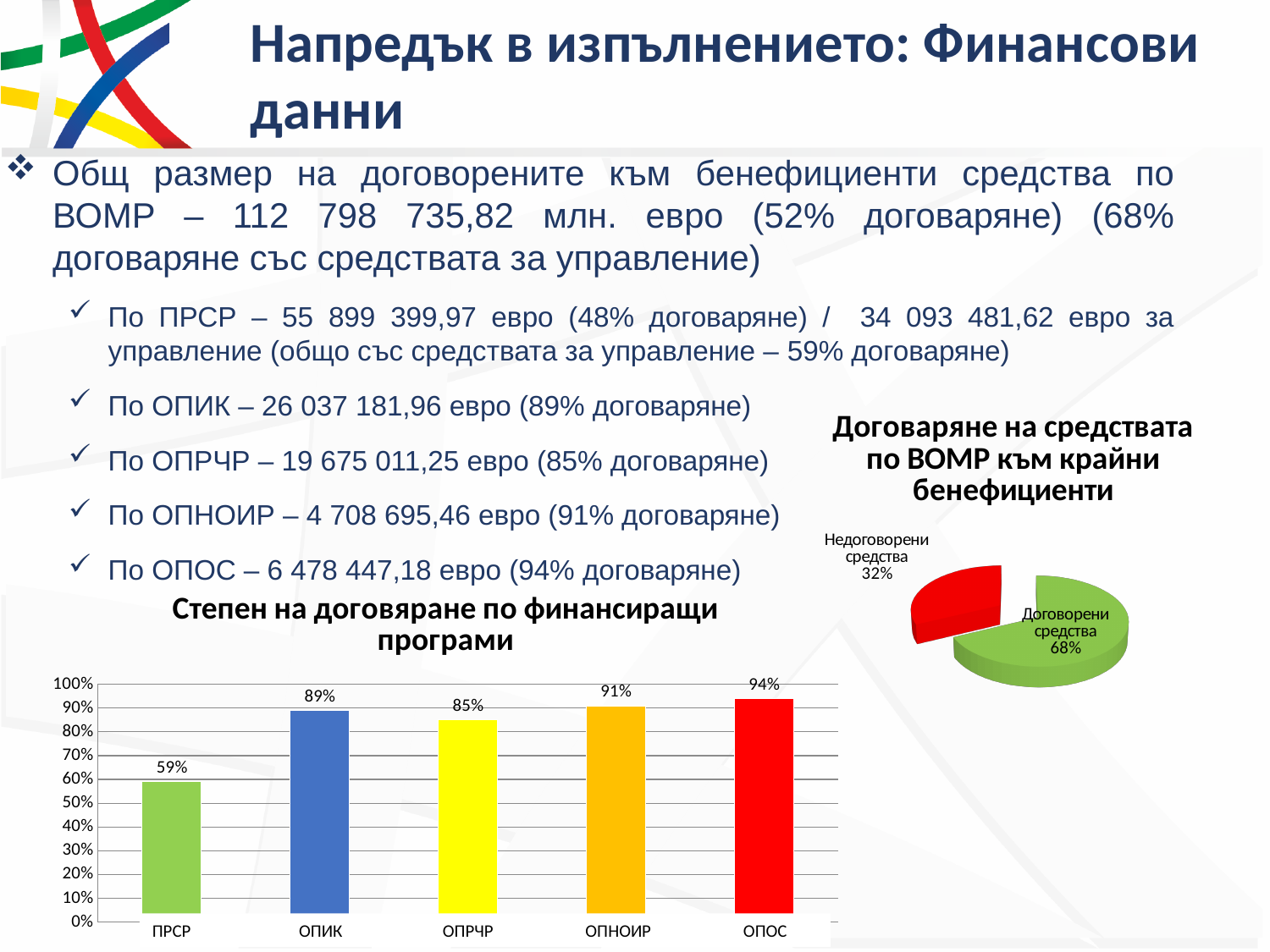
What kind of chart is 'Степен на договяране по финансиращи програми'? Bar chart In the pie chart 'Договаряне на средствата по ВОМР към крайни бенефициенти', how many slices are there? 2 In the bar chart 'Степен на договяране по финансиращи програми', which program has the lowest value? ПРСР In the bar chart 'Степен на договяране по финансиращи програми', which is larger, the value for ОПИК or the value for ОПНОИР? ОПНОИР In the bar chart 'Степен на договяране по финансиращи програми', what is the difference between the values for ОПОС and ПРСР? 35% In the bar chart 'Степен на договяране по финансиращи програми', what is the value for ПРСР? 59% In the bar chart 'Степен на договяране по финансиращи програми', how many programs are shown on the x axis? 5 In the bar chart 'Степен на договяране по финансиращи програми', what is the value for ОПРЧР? 85% In the pie chart 'Договаряне на средствата по ВОМР към крайни бенефициенти', what share is labelled 'Недоговорени средства'? 32% In the pie chart 'Договаряне на средствата по ВОМР към крайни бенефициенти', what share is labelled 'Договорени средства'? 68% In the bar chart 'Степен на договяране по финансиращи програми', which program has the highest value? ОПОС In the pie chart 'Договаряне на средствата по ВОМР към крайни бенефициенти', what colour is the 'Недоговорени средства' slice? Red